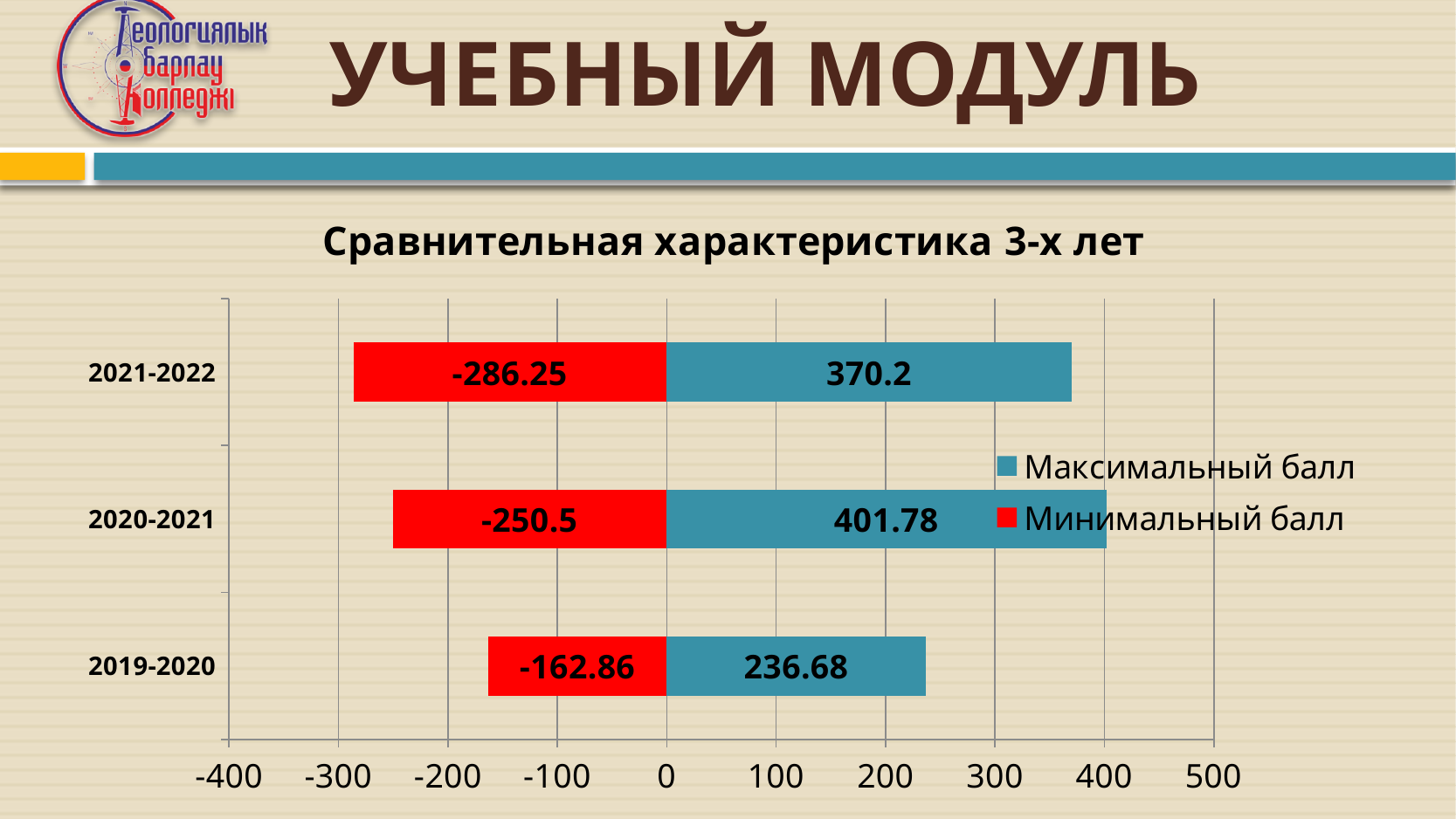
What is the Минимальный балл value for 2021-2022? -286.25 How many series does the legend list? 2 How many years (categories) are shown in the chart? 3 Which year has the lowest (most negative) Минимальный балл? 2021-2022 What type of chart is shown on the slide? Bar chart What is the Максимальный балл value for 2019-2020? 236.68 Which is larger, the Максимальный балл for 2021-2022 or for 2019-2020? 2021-2022 Which year has the lowest Максимальный балл? 2019-2020 What is the Максимальный балл value for 2020-2021? 401.78 What is the Минимальный балл value for 2019-2020? -162.86 What is the difference between the Максимальный балл for 2020-2021 and 2021-2022? 31.58 Which year has the highest Максимальный балл? 2020-2021